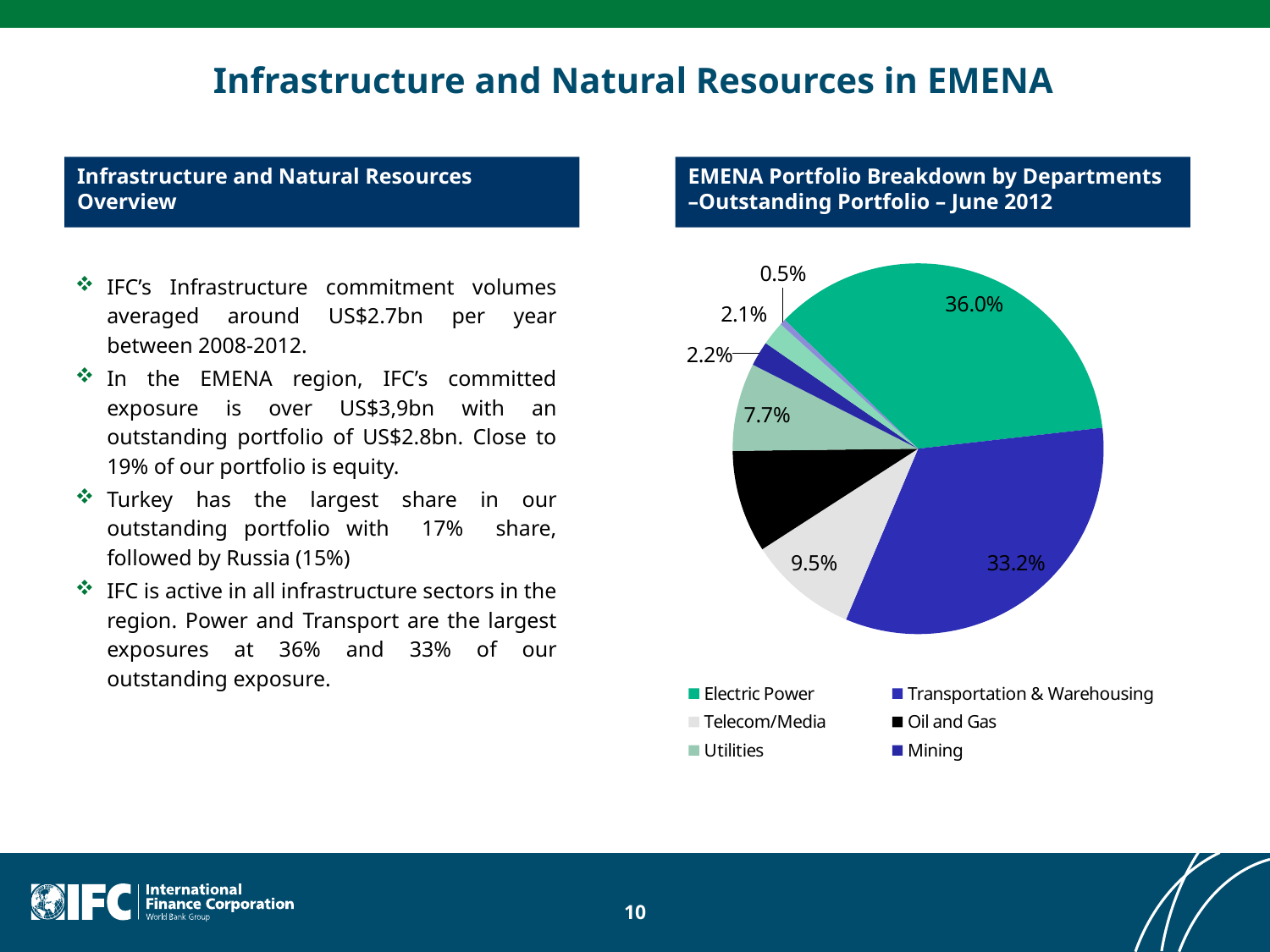
Which is larger, the share for Telecom/Media or the share for Transportation & Warehousing? Transportation & Warehousing Which is larger, the share for Electric Power or the share for Transportation & Warehousing? Electric Power What share of the outstanding portfolio is Transportation & Warehousing? 33.2% What is the smallest percentage label shown on the pie chart? 0.5% What colour is the Electric Power slice in the pie chart? green How many entries does the chart legend list? 6 Which department has the largest share of the pie? Electric Power What share of the outstanding portfolio is Electric Power? 36.0% What share of the outstanding portfolio is Telecom/Media? 9.5% What is the title of the chart? EMENA Portfolio Breakdown by Departments –Outstanding Portfolio – June 2012 What type of chart is shown on the slide? pie chart What is the difference in percentage points between the Electric Power share and the Transportation & Warehousing share? 2.8